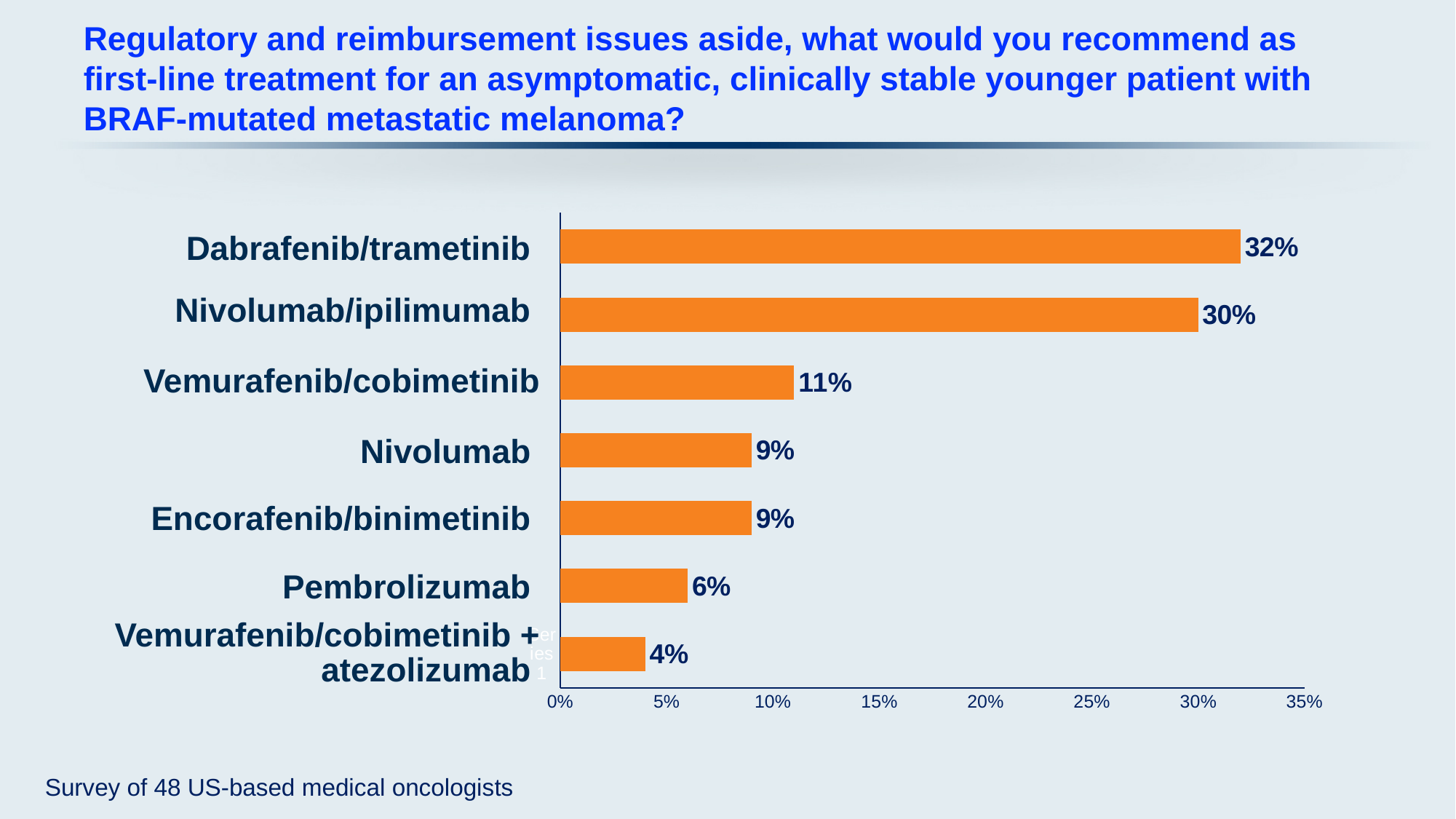
What is the value shown for Vemurafenib/cobimetinib? 11% How many treatment options are shown in the chart? 7 How many oncologists were surveyed, according to the note at the bottom of the slide? 48 What is the value for Vemurafenib/cobimetinib + atezolizumab? 4% Which treatment has the highest percentage? Dabrafenib/trametinib What percentage of respondents recommended Dabrafenib/trametinib? 32% What is the difference between the values for Vemurafenib/cobimetinib and Pembrolizumab? 5% What is the difference between the values for Dabrafenib/trametinib and Nivolumab/ipilimumab? 2% What kind of chart is shown on the slide? Bar chart Which has a larger value, Nivolumab/ipilimumab or Vemurafenib/cobimetinib? Nivolumab/ipilimumab What percentage is shown for Pembrolizumab? 6% Which treatment has the lowest percentage? Vemurafenib/cobimetinib + atezolizumab